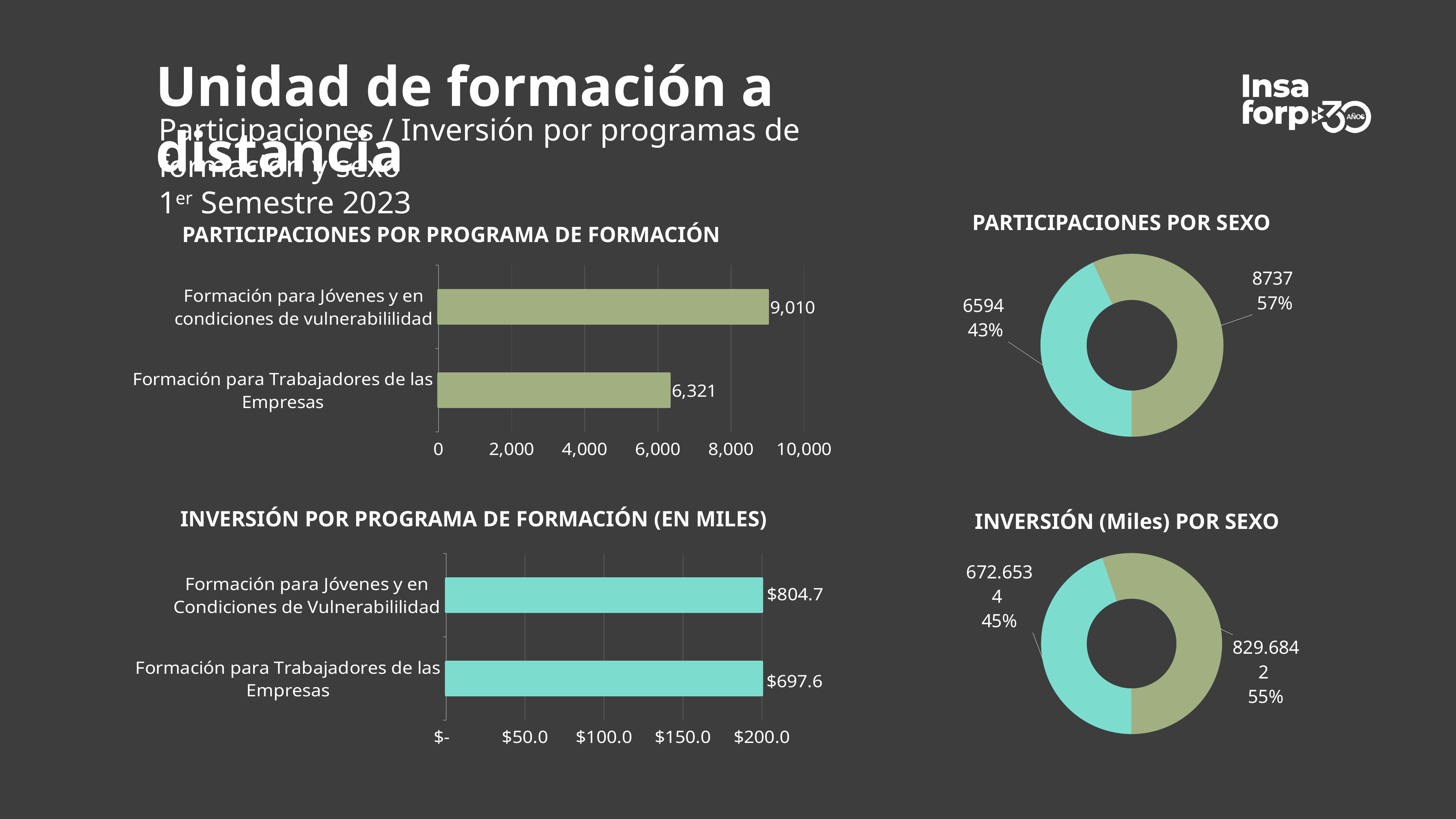
In the chart 'INVERSIÓN POR PROGRAMA DE FORMACIÓN (EN MILES)', what is the value for Formación para Trabajadores de las Empresas? $697.6 In the chart 'PARTICIPACIONES POR SEXO', what percentage share does the larger slice have? 57% In the chart 'PARTICIPACIONES POR PROGRAMA DE FORMACIÓN', what is the difference between the two programs' values? 2,689 In the chart 'INVERSIÓN POR PROGRAMA DE FORMACIÓN (EN MILES)', what is the value for Formación para Jóvenes y en Condiciones de Vulnerabililidad? $804.7 In the chart 'INVERSIÓN POR PROGRAMA DE FORMACIÓN (EN MILES)', how many categories are shown? 2 In the chart 'PARTICIPACIONES POR PROGRAMA DE FORMACIÓN', what is the value for Formación para Trabajadores de las Empresas? 6,321 What kind of chart is 'PARTICIPACIONES POR PROGRAMA DE FORMACIÓN'? Bar chart In the chart 'INVERSIÓN (Miles) POR SEXO', what percentage share does the smaller slice have? 45% In the chart 'INVERSIÓN POR PROGRAMA DE FORMACIÓN (EN MILES)', which program has the lowest investment? Formación para Trabajadores de las Empresas In the chart 'PARTICIPACIONES POR PROGRAMA DE FORMACIÓN', which program has the highest number of participations? Formación para Jóvenes y en condiciones de vulnerabililidad In the chart 'PARTICIPACIONES POR SEXO', what is the value of the slice labelled 43%? 6594 In the chart 'PARTICIPACIONES POR PROGRAMA DE FORMACIÓN', what is the value for Formación para Jóvenes y en condiciones de vulnerabililidad? 9,010